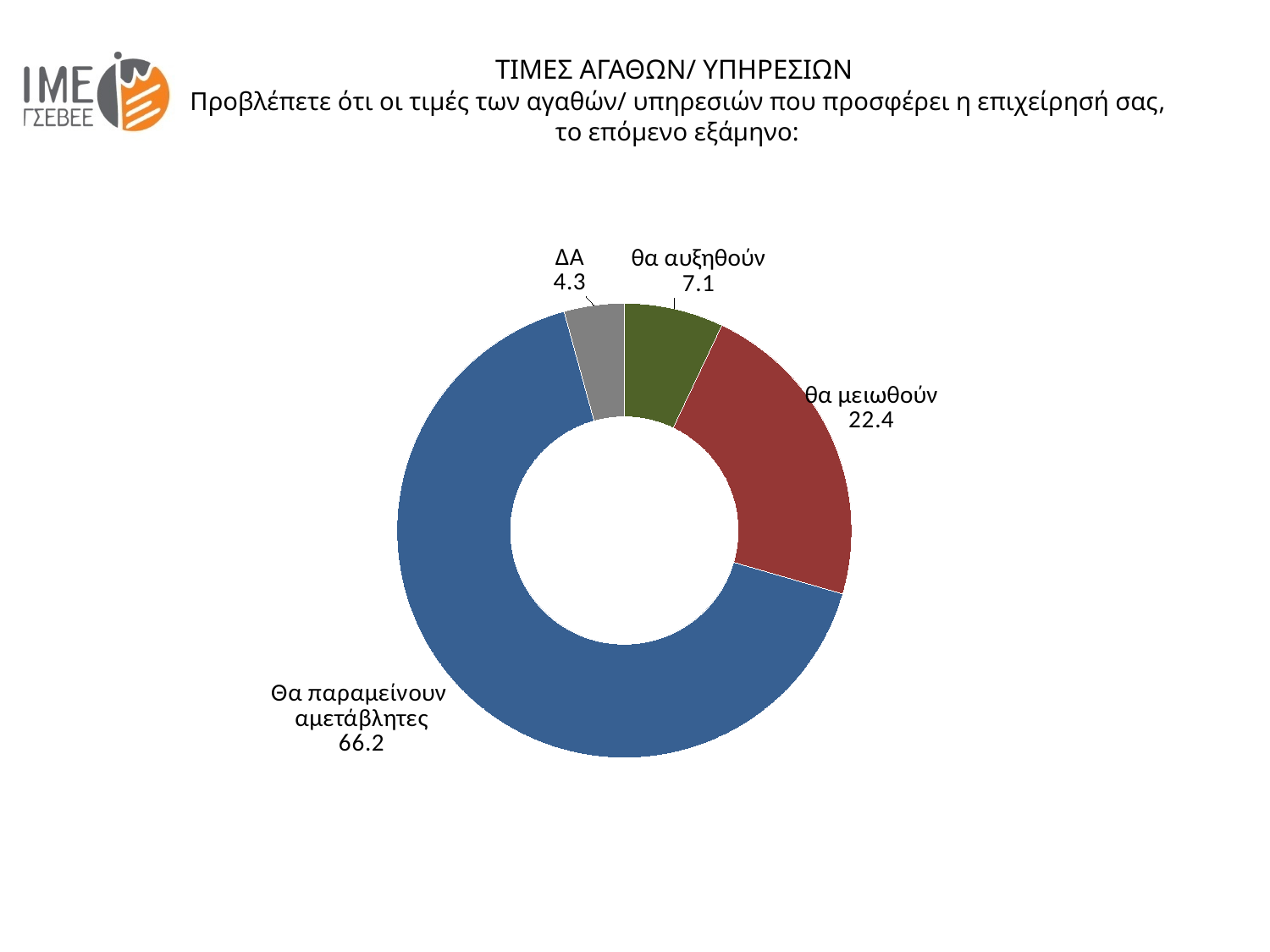
Which category has the largest share? Θα παραμείνουν αμετάβλητες Which category has the smallest share? ΔΑ What is the value for 'ΔΑ'? 4.3 What is the difference between the values for 'θα μειωθούν' and 'θα αυξηθούν'? 15.3 What colour is the slice for 'θα μειωθούν'? Red Which is larger, the value for 'θα αυξηθούν' or the value for 'ΔΑ'? θα αυξηθούν What is the value for 'θα αυξηθούν'? 7.1 What is the value for 'θα μειωθούν'? 22.4 What is the difference between the values for 'Θα παραμείνουν αμετάβλητες' and 'θα μειωθούν'? 43.8 How many categories are shown in the chart? 4 What is the value for 'Θα παραμείνουν αμετάβλητες'? 66.2 What kind of chart is shown on the slide? Doughnut (pie) chart